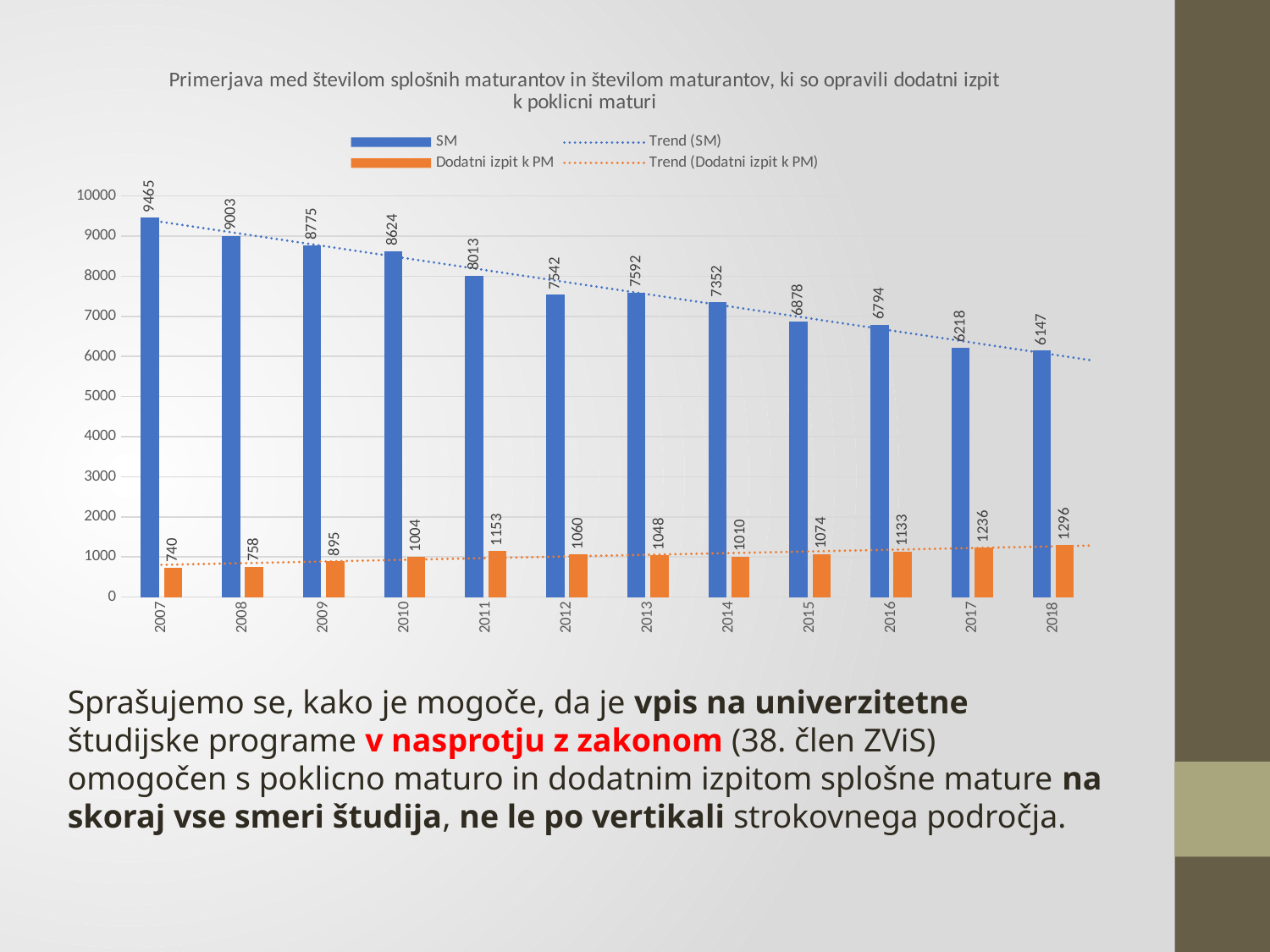
What colour are the SM bars? blue What is the SM value for 2007? 9465 How many years are shown on the x axis? 12 What is the Dodatni izpit k PM value for 2018? 1296 How many entries does the legend list? 4 What is the difference between the SM value in 2007 and the SM value in 2018? 3318 Which year has the highest SM value? 2007 Which year has the lowest Dodatni izpit k PM value? 2007 What kind of chart is shown on the slide? bar chart Do the SM values generally rise or fall from 2007 to 2018? fall What is the SM value for 2013? 7592 Which is larger, the Dodatni izpit k PM value for 2011 or for 2012? 2011